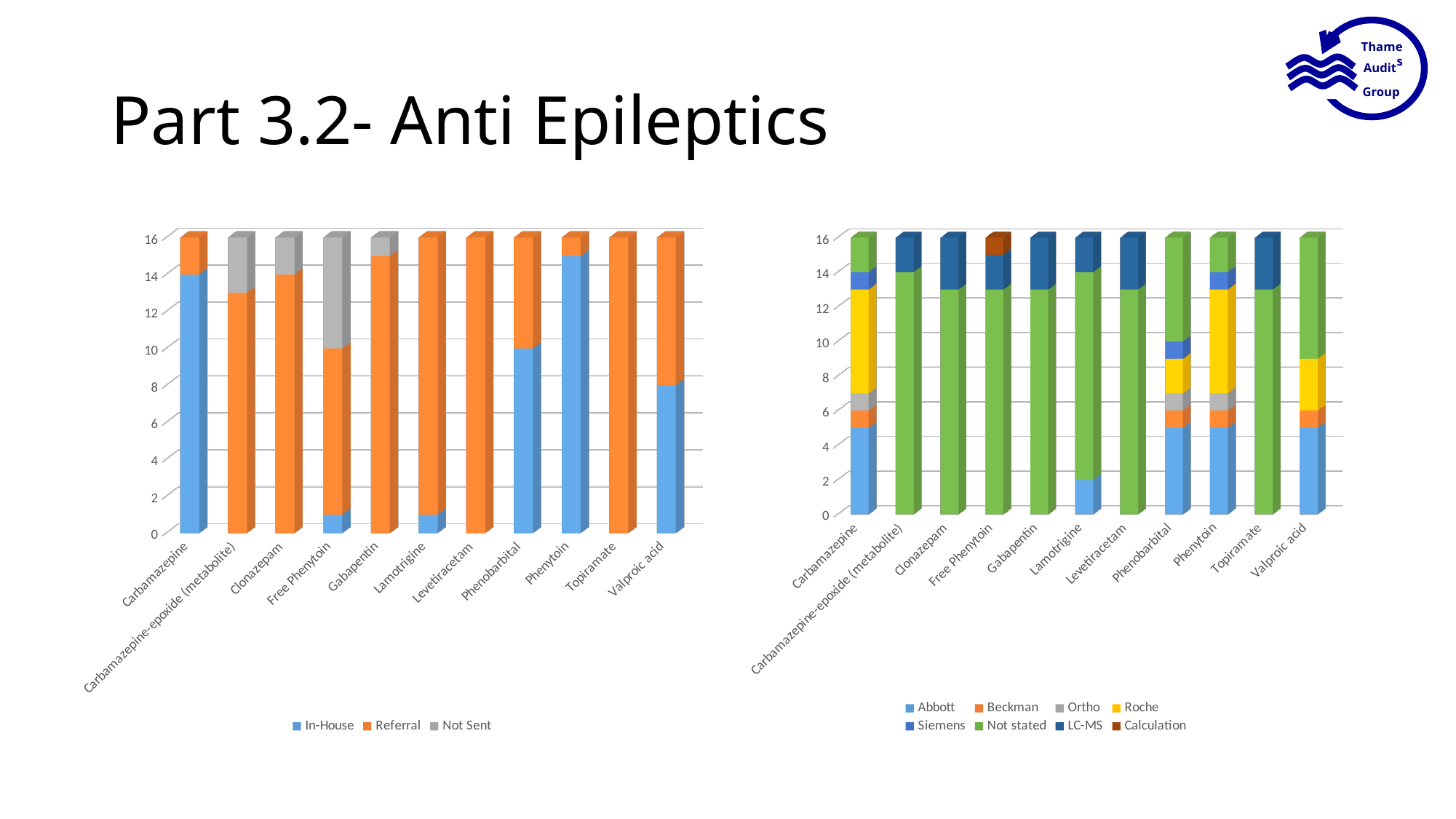
In the left chart, is the In-House value for Valproic acid greater or less than 10? less In the left chart, which category has the largest Not Sent segment? Free Phenytoin In the right chart, which category is the only one with a Calculation segment? Free Phenytoin What kind of chart is the left chart on the slide? stacked bar chart In the left chart, which category has the largest In-House segment, Phenytoin or Phenobarbital? Phenytoin In the right chart, is the Not stated value for Topiramate greater or less than 10? greater How many series does the legend of the left chart list? 3 In the left chart, is the In-House value for Carbamazepine greater or less than 12? greater In the right chart, which series is shown in yellow? Roche How many categories are shown on the x axis of the left chart? 11 How many series does the legend of the right chart list? 8